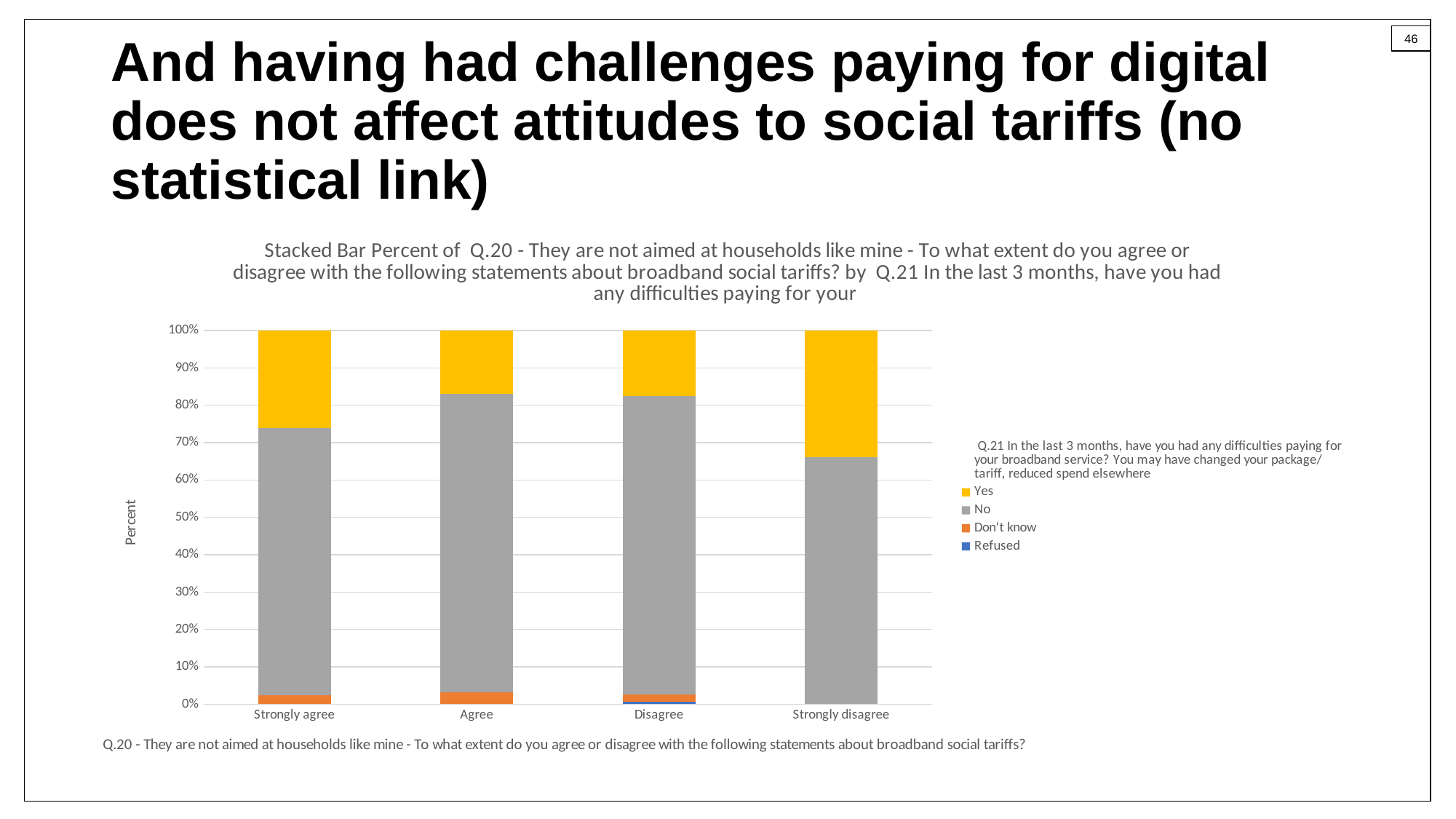
How many categories are shown along the x axis of the chart? 4 Which category has the largest 'Yes' segment? Strongly disagree Which colour represents the 'Yes' series in the chart? Yellow What kind of chart is shown on the slide? Stacked bar chart Is the 'Yes' segment larger for Strongly disagree or for Agree? Strongly disagree Is the 'No' share for Strongly disagree greater or less than 70%? less Which category has the smallest 'No' segment? Strongly disagree What is the total height of each stacked bar on the y axis? 100% Is the 'Yes' share for Strongly disagree greater or less than 30%? greater Is the 'No' segment larger for Agree or for Strongly agree? Agree How many series does the chart's legend list? 4